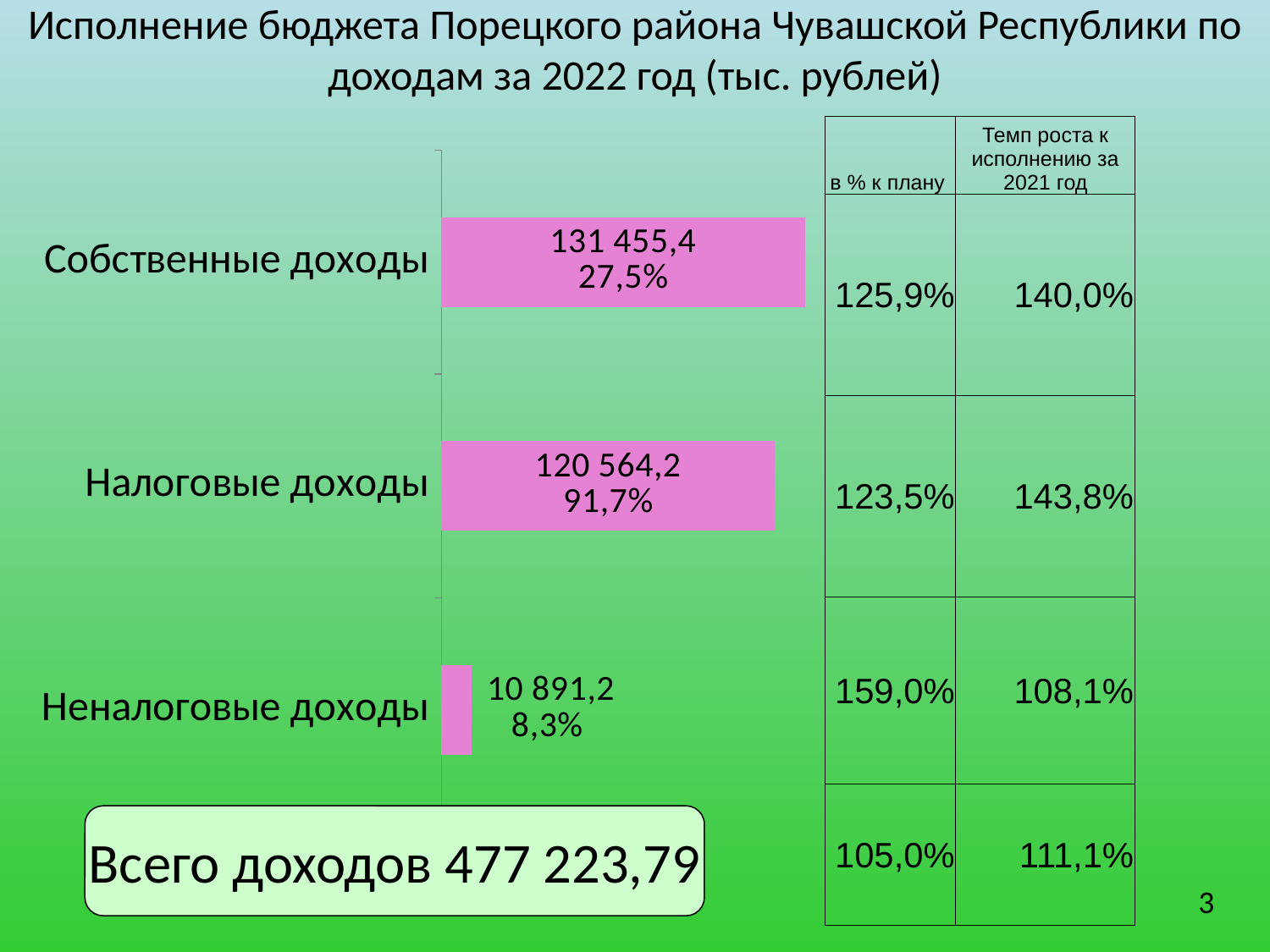
What is the difference between the values for Собственные доходы and Налоговые доходы? 10 891,2 What percentage is printed on the bar for Налоговые доходы? 91,7% What is the value shown for Налоговые доходы? 120 564,2 Which is larger, the value for Налоговые доходы or the value for Неналоговые доходы? Налоговые доходы What is the title of the slide containing the bar chart? Исполнение бюджета Порецкого района Чувашской Республики по доходам за 2022 год (тыс. рублей) What is the value shown for Собственные доходы? 131 455,4 What kind of chart is shown on the slide? Bar chart What is the value shown for Неналоговые доходы? 10 891,2 Which category has the lowest value in the bar chart? Неналоговые доходы What percentage is printed on the bar for Неналоговые доходы? 8,3% Which category has the highest value in the bar chart? Собственные доходы How many categories does the bar chart show? 3